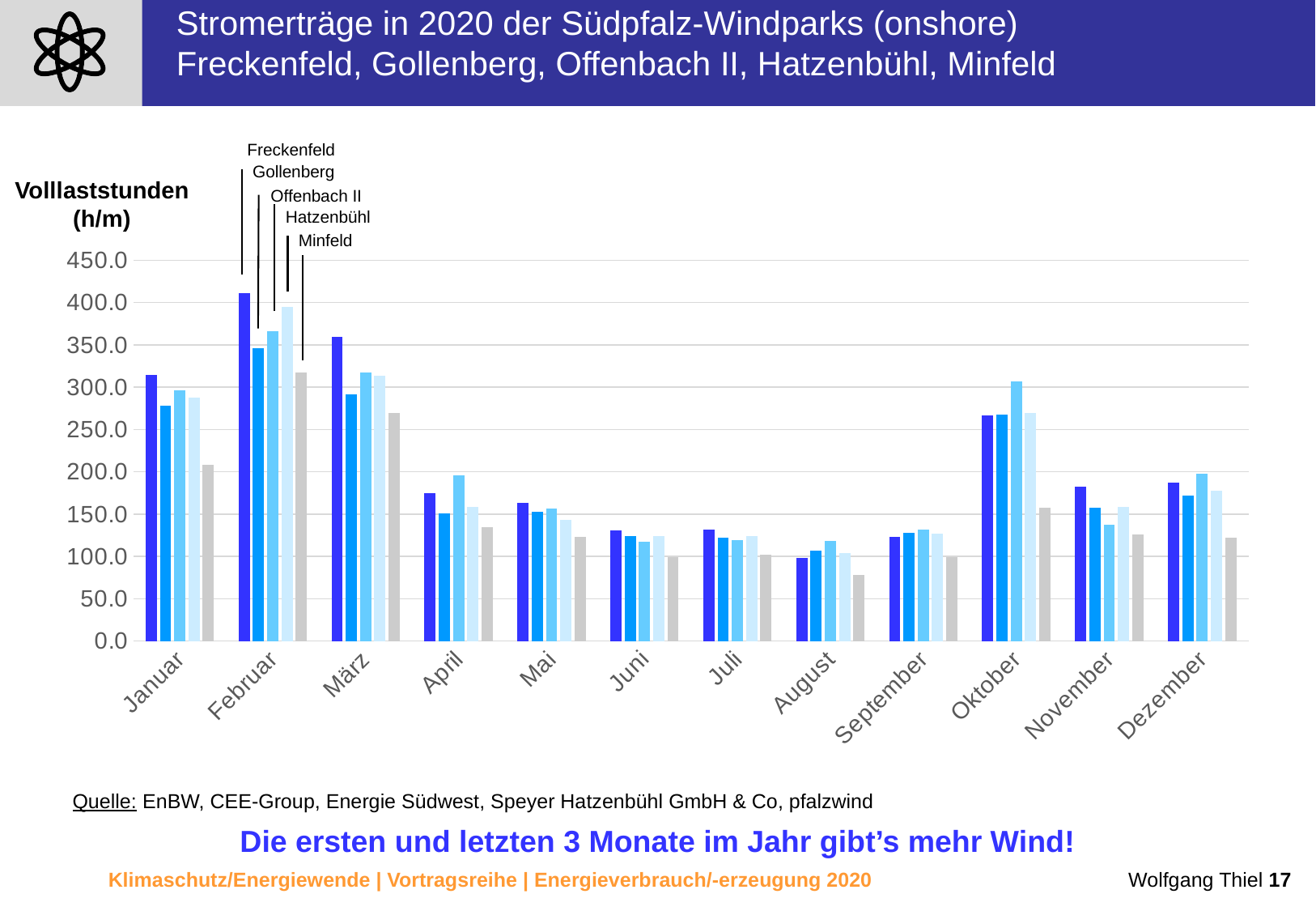
In which month does Freckenfeld reach its highest value? Februar In which month does Freckenfeld have its lowest value? August Do the Freckenfeld values rise or fall from Februar to August? fall Is the value for Hatzenbühl in Oktober greater or less than 300.0? less How many wind parks (series) does the chart's legend list? 5 What kind of chart is shown on the slide? bar chart Is the value for Freckenfeld in Februar greater or less than 400.0? greater How many months are shown on the x axis of the chart? 12 What unit is given for the y axis of the chart? Volllaststunden (h/m) Is the value for Minfeld in August greater or less than 100.0? less